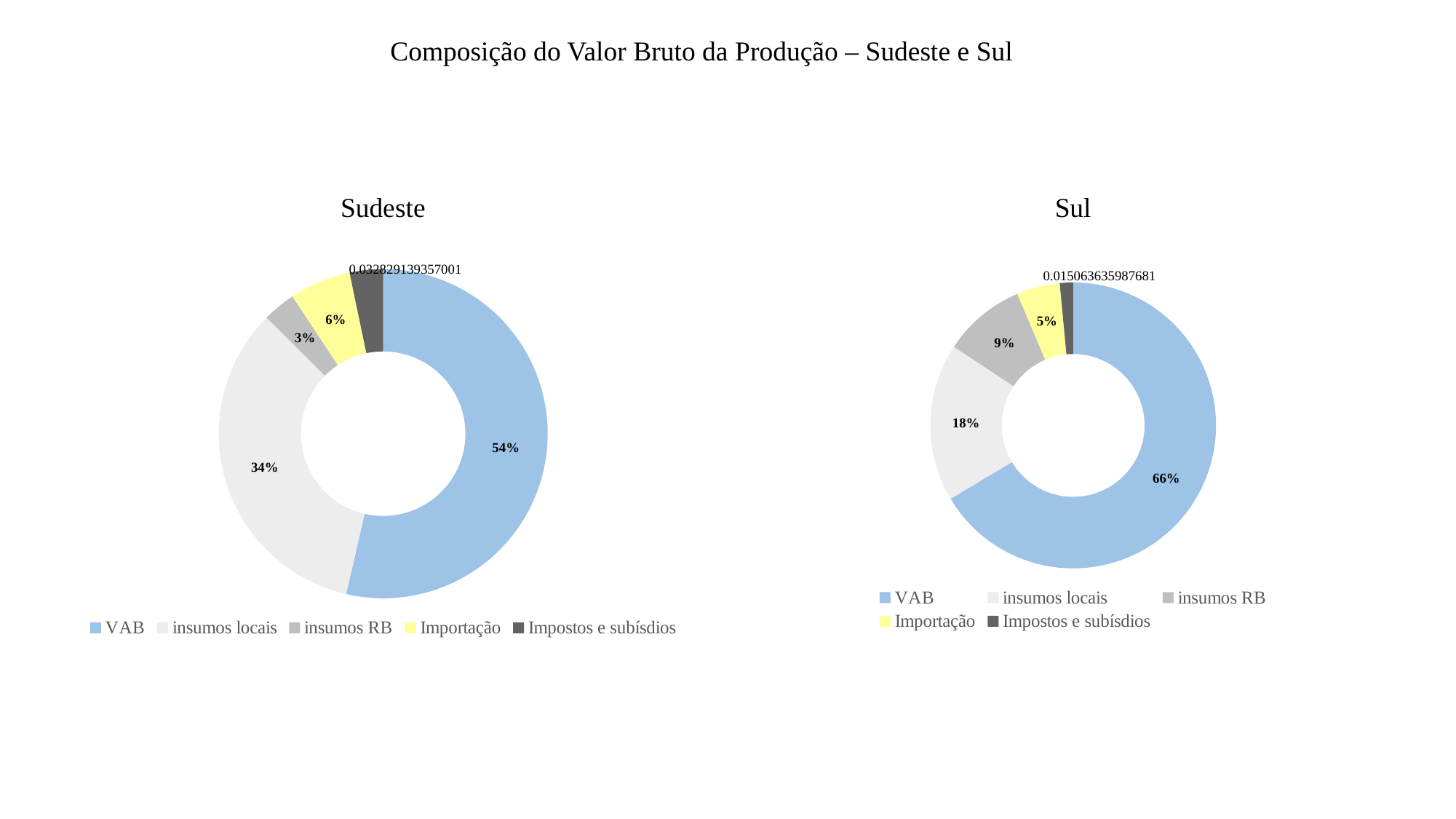
In the Sudeste chart, which category has the largest share? VAB In the Sudeste chart, what is the difference between the VAB share and the insumos locais share? 20% In the Sul chart, what share does VAB have? 66% Which is larger in the Sudeste chart: Importação or insumos RB? Importação In the Sul chart, what is the label shown for Impostos e subísdios? 0.015063635987681 How many categories does the legend of the Sul chart list? 5 What is the title of the slide? Composição do Valor Bruto da Produção – Sudeste e Sul In the Sul chart, which category has the smallest share? Impostos e subísdios In the Sudeste chart, what share do insumos locais have? 34% What kind of chart is the Sudeste chart? doughnut chart In the Sul chart, what share do insumos RB have? 9% In the Sudeste chart, what share does VAB have? 54%